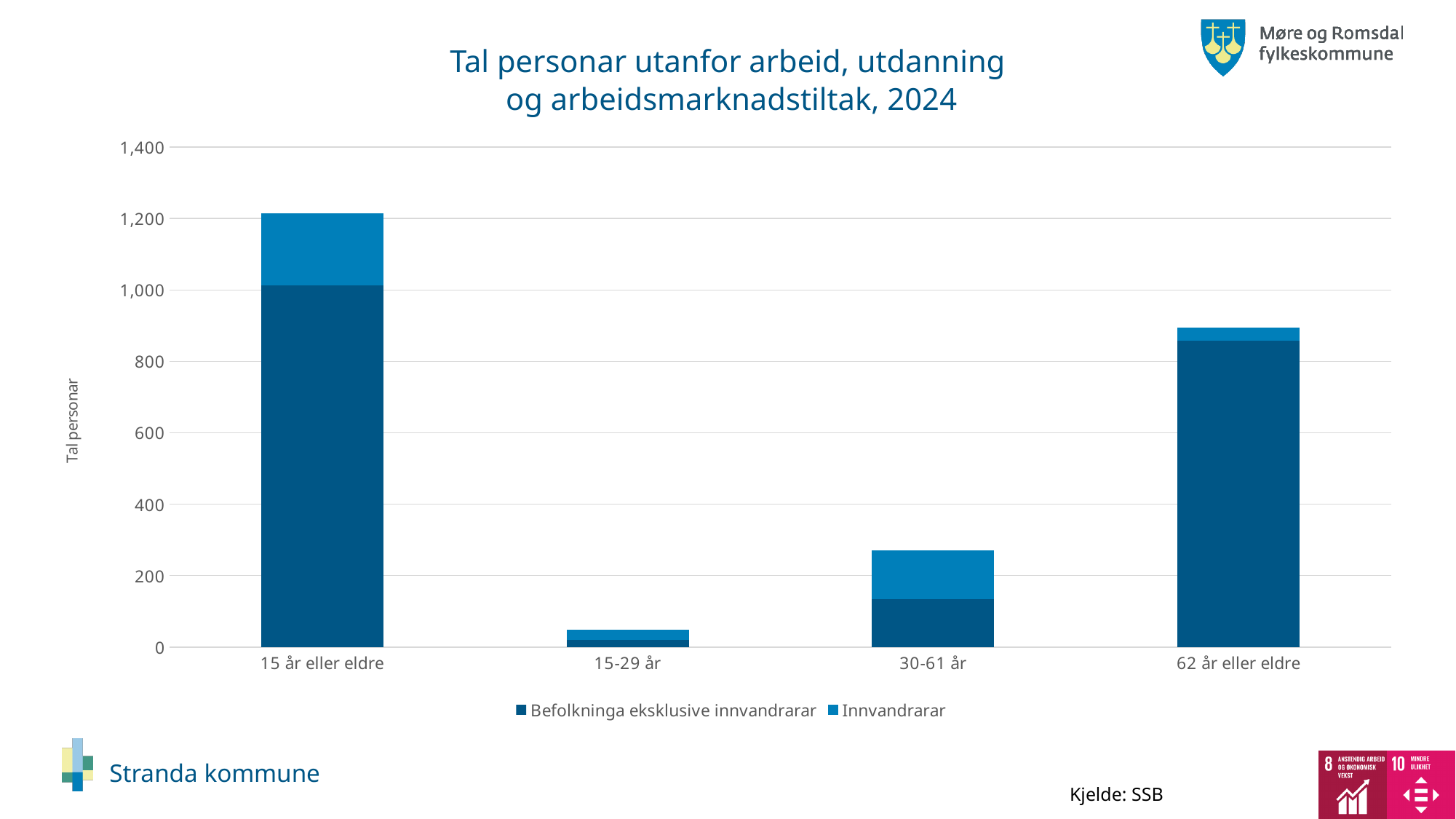
How many series does the legend list? 2 Is the total value for 30-61 år greater or less than 400? less What are the two series named in the legend? Befolkninga eksklusive innvandrarar and Innvandrarar Is the total value for 15 år eller eldre greater or less than 1,000? greater Which stacked bar is taller: 62 år eller eldre or 30-61 år? 62 år eller eldre Is the total value for 62 år eller eldre greater or less than 800? greater How many age categories are shown on the x axis? 4 What kind of chart is shown on the slide? bar chart Which age category has the shortest stacked bar? 15-29 år Which age category has the tallest stacked bar? 15 år eller eldre What is the label on the y axis? Tal personar